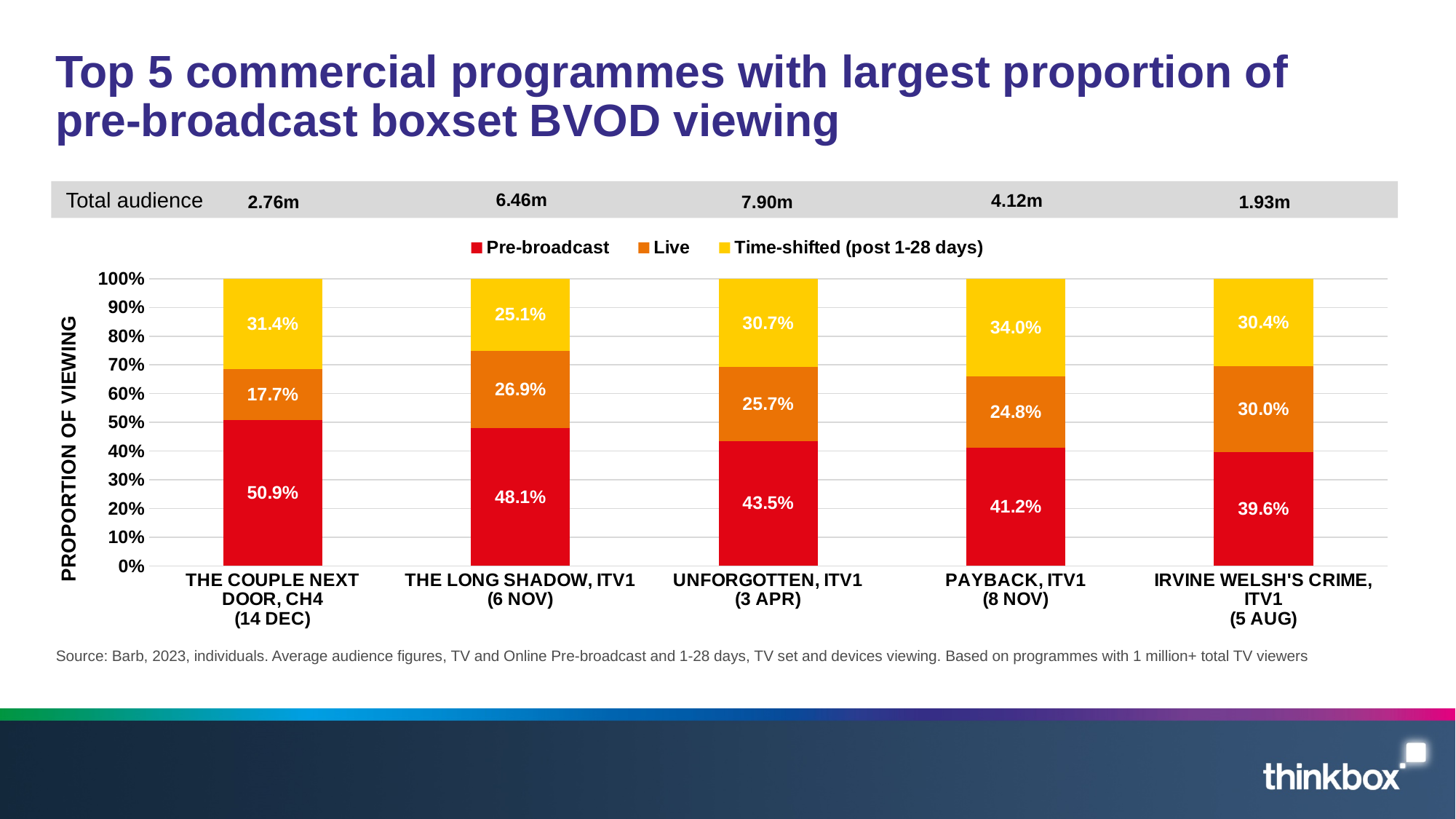
Which programme has the lowest Live proportion of viewing? THE COUPLE NEXT DOOR, CH4 (14 DEC) What is the difference between the Pre-broadcast proportions for THE LONG SHADOW, ITV1 (6 NOV) and UNFORGOTTEN, ITV1 (3 APR)? 4.6% What is the total audience shown for UNFORGOTTEN, ITV1 (3 APR)? 7.90m What is the Live proportion of viewing for IRVINE WELSH'S CRIME, ITV1 (5 AUG)? 30.0% What is the Pre-broadcast proportion of viewing for THE COUPLE NEXT DOOR, CH4 (14 DEC)? 50.9% Do the Pre-broadcast proportions rise or fall from left to right along the x axis? Fall How many series does the legend list? 3 What is the Time-shifted (post 1-28 days) proportion of viewing for PAYBACK, ITV1 (8 NOV)? 34.0% How many programmes are shown on the x axis of the chart? 5 Which programme has the highest Pre-broadcast proportion of viewing? THE COUPLE NEXT DOOR, CH4 (14 DEC) Which is larger: the Time-shifted proportion for THE LONG SHADOW, ITV1 (6 NOV) or for UNFORGOTTEN, ITV1 (3 APR)? UNFORGOTTEN, ITV1 (3 APR) What kind of chart is shown on the slide? Stacked bar chart